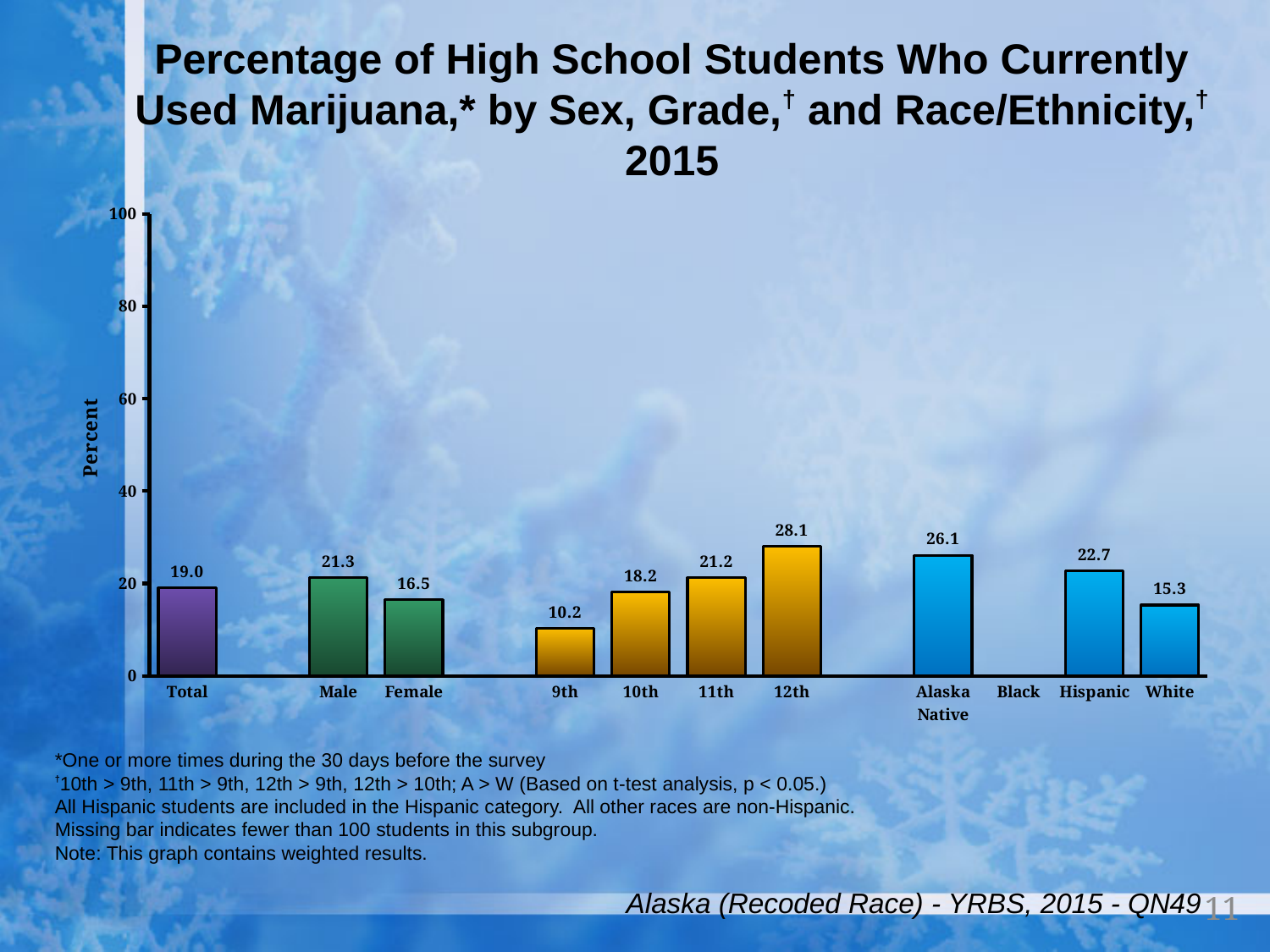
Which category has no bar plotted? Black What is the difference between the Male and Female values? 4.8 What is the value for 12th grade? 28.1 What is the label on the vertical axis? Percent Which category has the highest value? 12th Do the values rise or fall from 9th grade to 12th grade? rise What is the value for Total? 19.0 What is the value for Alaska Native? 26.1 Which is larger, the value for Hispanic or the value for White? Hispanic Which category with a plotted bar has the lowest value? 9th What kind of chart is shown on the slide? bar chart Is the value for 11th grade greater or less than 20? greater